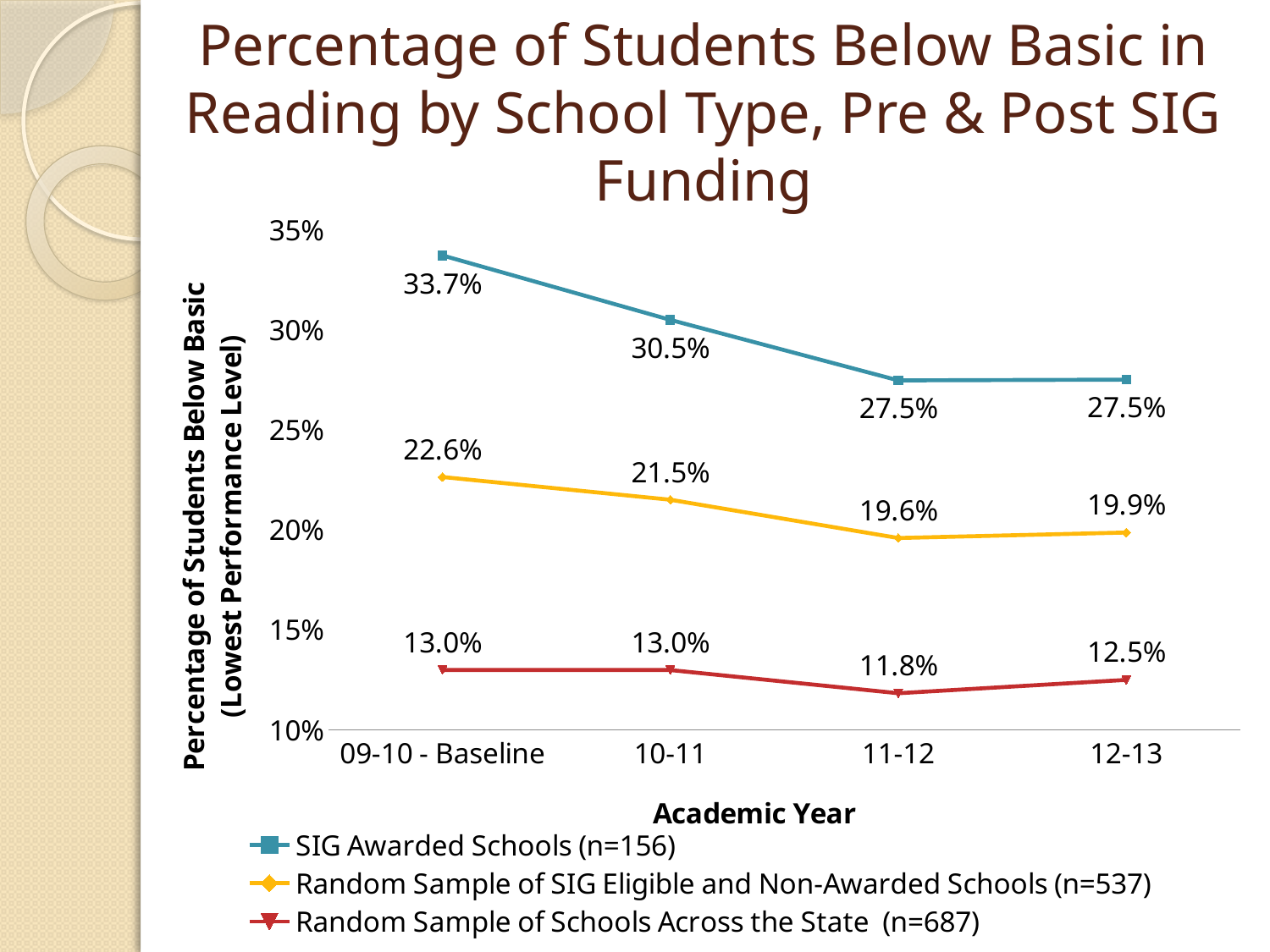
What is the value for Random Sample of SIG Eligible and Non-Awarded Schools (n=537) in 11-12? 19.6% How many academic years are shown on the x axis? 4 What is the difference between the SIG Awarded Schools (n=156) values in 09-10 - Baseline and 12-13? 6.2% What is the value for SIG Awarded Schools (n=156) in 09-10 - Baseline? 33.7% Is the value for Random Sample of SIG Eligible and Non-Awarded Schools (n=537) in 09-10 - Baseline greater or less than 20%? greater What kind of chart is shown on the slide? Line chart What is the value for Random Sample of Schools Across the State (n=687) in 12-13? 12.5% Does the value for SIG Awarded Schools (n=156) rise or fall from 09-10 - Baseline to 11-12? Fall In which academic year is the value for SIG Awarded Schools (n=156) highest? 09-10 - Baseline How many series does the legend list? 3 Which series has the larger value in 10-11: SIG Awarded Schools (n=156) or Random Sample of SIG Eligible and Non-Awarded Schools (n=537)? SIG Awarded Schools (n=156) In which academic year is the value for Random Sample of Schools Across the State (n=687) lowest? 11-12